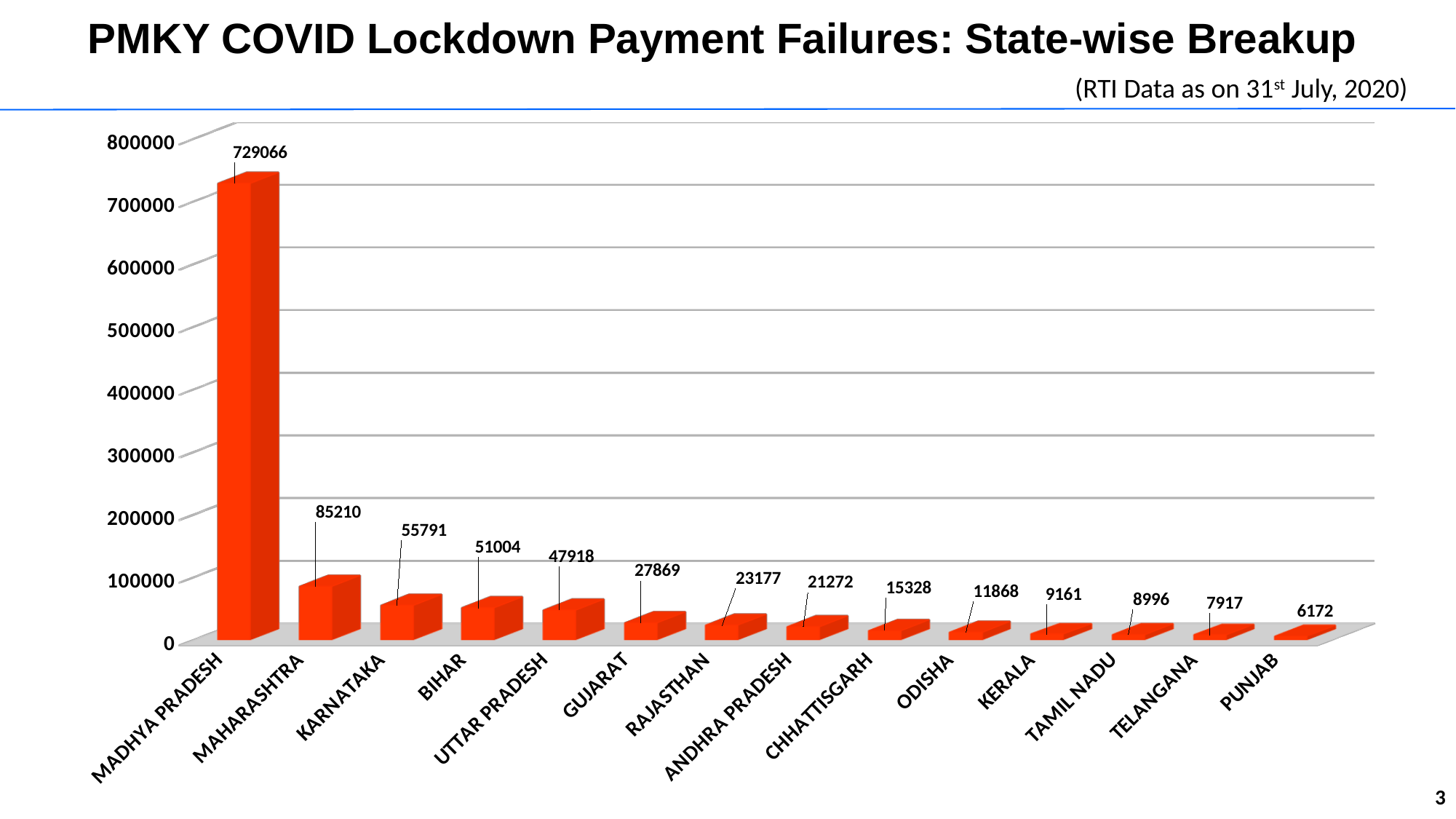
Which state has the highest value? MADHYA PRADESH Do the values rise or fall from left to right along the x axis? fall Which state has the lowest value? PUNJAB What is the title of the slide? PMKY COVID Lockdown Payment Failures: State-wise Breakup Which is larger, the value for BIHAR or the value for UTTAR PRADESH? BIHAR How many states are shown on the chart? 14 What is the difference between the values for MAHARASHTRA and KARNATAKA? 29419 What is the value for MADHYA PRADESH? 729066 What is the value for ODISHA? 11868 What is the value for KARNATAKA? 55791 Is the value for MADHYA PRADESH greater or less than 700000? greater What kind of chart is shown on the slide? bar chart